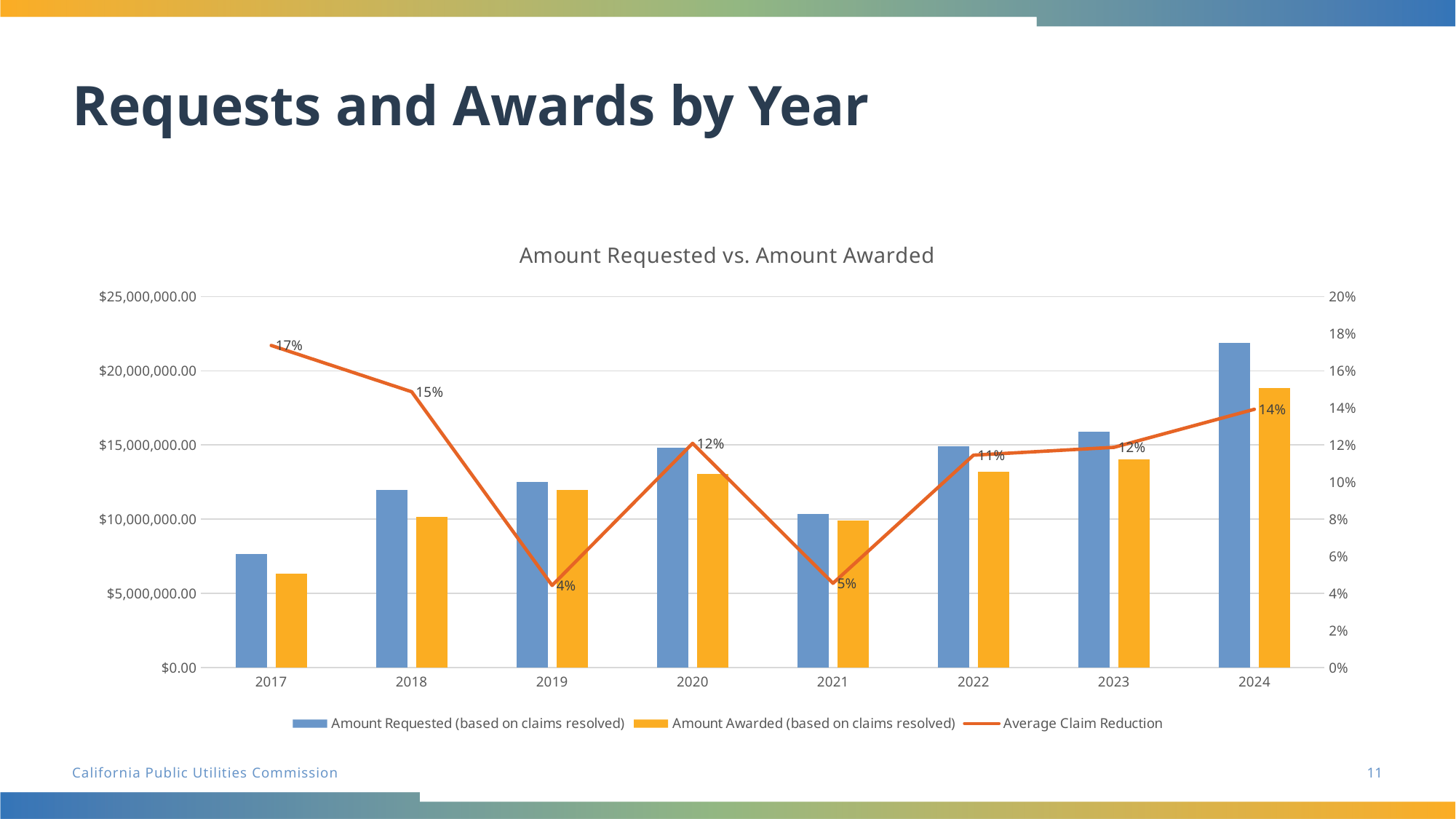
Which year has the lowest Average Claim Reduction? 2019 Is the Amount Requested for 2024 greater or less than $20,000,000.00? greater What is the Average Claim Reduction for 2017? 17% What is the Average Claim Reduction for 2024? 14% Which year has the highest Average Claim Reduction? 2017 How many series does the chart's legend list? 3 How many years are shown on the x axis of the chart? 8 Which year has the highest Amount Requested (based on claims resolved)? 2024 What is the Average Claim Reduction for 2019? 4% What is the difference between the Average Claim Reduction in 2017 and in 2019? 13% Which year has the lowest Amount Requested (based on claims resolved)? 2017 Is the Amount Awarded for 2017 greater or less than $10,000,000.00? less